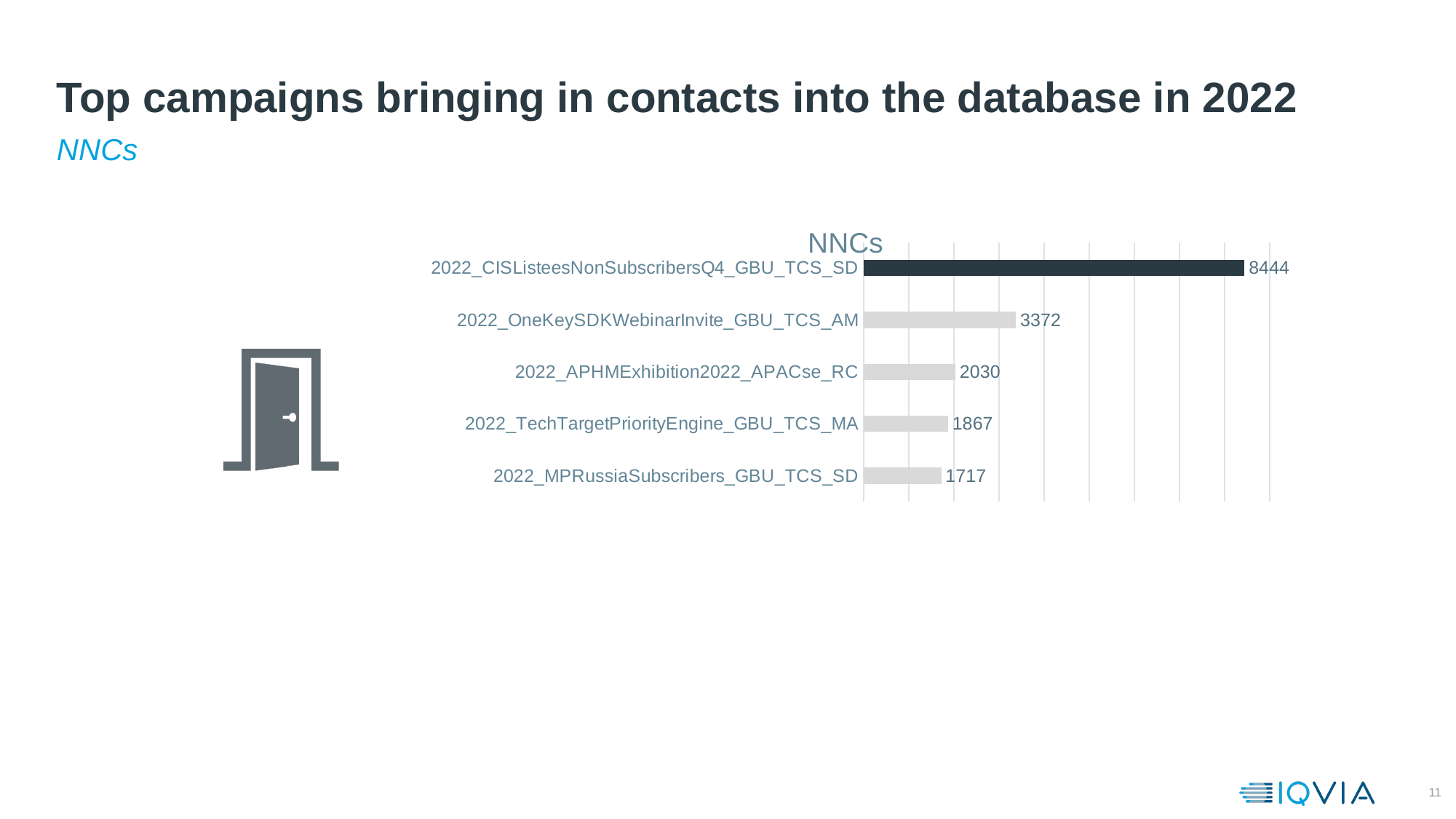
What is the NNCs value for 2022_MPRussiaSubscribers_GBU_TCS_SD? 1717 Which campaign has the highest NNCs value? 2022_CISListeesNonSubscribersQ4_GBU_TCS_SD How many campaigns are shown in the chart? 5 What is the difference in NNCs between 2022_TechTargetPriorityEngine_GBU_TCS_MA and 2022_MPRussiaSubscribers_GBU_TCS_SD? 150 What is the NNCs value for 2022_CISListeesNonSubscribersQ4_GBU_TCS_SD? 8444 What is the title of the chart? NNCs What is the NNCs value for 2022_APHMExhibition2022_APACse_RC? 2030 Which has a larger NNCs value: 2022_APHMExhibition2022_APACse_RC or 2022_TechTargetPriorityEngine_GBU_TCS_MA? 2022_APHMExhibition2022_APACse_RC Which campaign has the lowest NNCs value? 2022_MPRussiaSubscribers_GBU_TCS_SD What is the NNCs value for 2022_OneKeySDKWebinarInvite_GBU_TCS_AM? 3372 What kind of chart is shown on the slide? Bar chart What is the difference in NNCs between 2022_CISListeesNonSubscribersQ4_GBU_TCS_SD and 2022_OneKeySDKWebinarInvite_GBU_TCS_AM? 5072